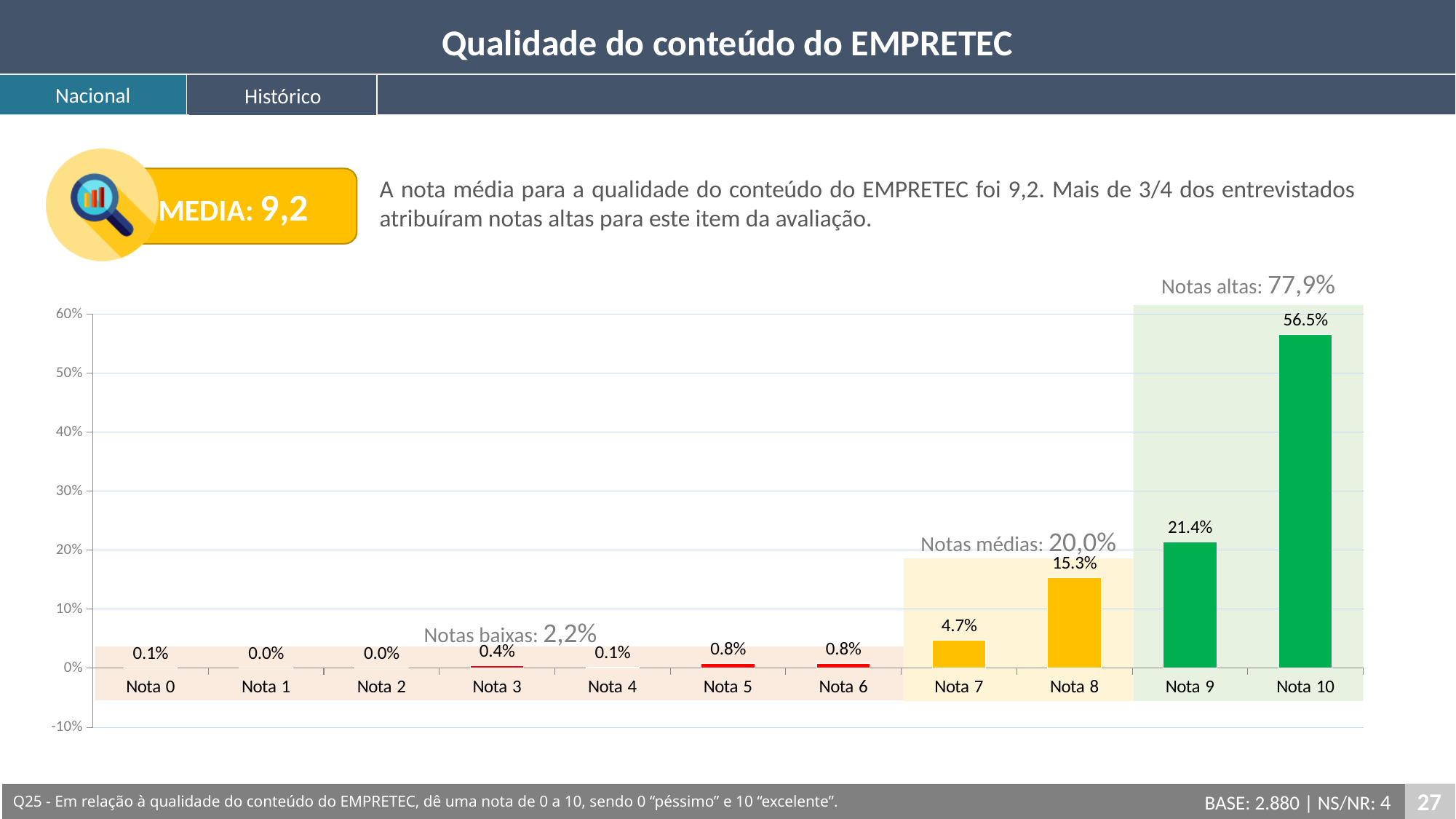
What is the value for Nota 8? 15.3% What percentage is shown for 'Notas altas'? 77,9% What is the value for Nota 3? 0.4% Is the value for Nota 10 greater or less than 50%? greater What is the value for Nota 7? 4.7% What is the average score (MEDIA) shown on the slide? 9,2 What is the difference between the values for Nota 10 and Nota 9? 35.1% How many categories are shown on the x axis? 11 What kind of chart is shown on the slide? Bar chart What is the value for Nota 10? 56.5% Which category has the highest value? Nota 10 Which is larger, the value for Nota 8 or the value for Nota 9? Nota 9